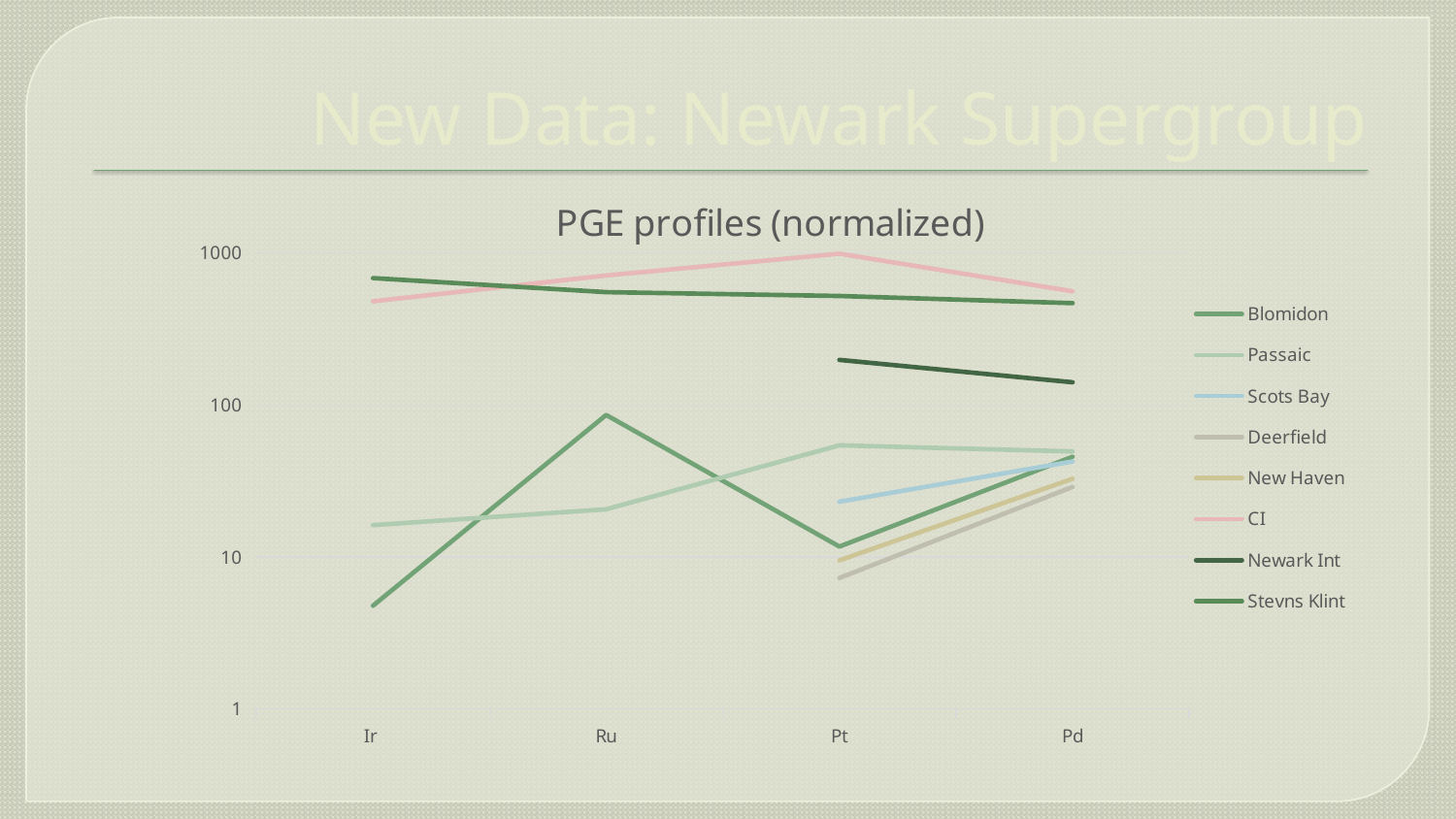
What is the title of the chart? PGE profiles (normalized) How many categories are on the x axis? 4 Is the value for Deerfield at Pt greater or less than 10? less Is the value for Blomidon at Ir greater or less than 10? less At Pd, which series is higher: Stevns Klint or Newark Int? Stevns Klint How many series does the legend list? 8 Is the value for CI at Pt greater or less than 100? greater What kind of chart is shown on the slide? line chart Which series has the highest value at Pt? CI